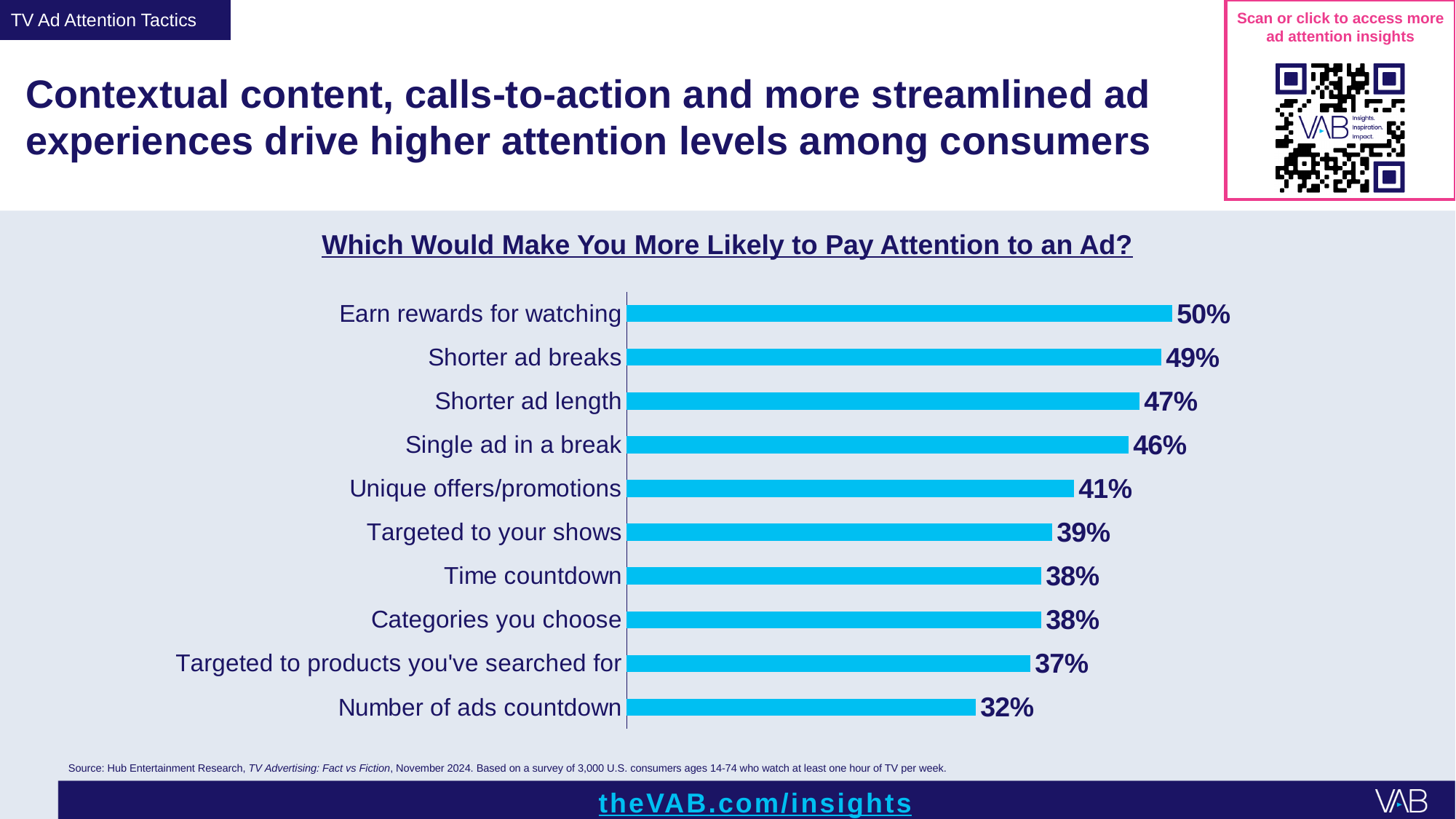
Which category has the lowest value in the chart? Number of ads countdown What is the value shown for 'Number of ads countdown'? 32% What is the difference in percentage points between 'Earn rewards for watching' and 'Number of ads countdown'? 18 What is the difference in percentage points between 'Shorter ad length' and 'Targeted to your shows'? 8 What is the value shown for 'Unique offers/promotions'? 41% Which category has the highest value in the chart? Earn rewards for watching What is the title of the chart? Which Would Make You More Likely to Pay Attention to an Ad? How many categories are shown in the chart? 10 What percentage of respondents said 'Earn rewards for watching' would make them more likely to pay attention to an ad? 50% Which two categories share the same value of 38%? Time countdown and Categories you choose Which has a higher value: 'Single ad in a break' or 'Targeted to products you've searched for'? Single ad in a break What type of chart is shown on the slide? Bar chart